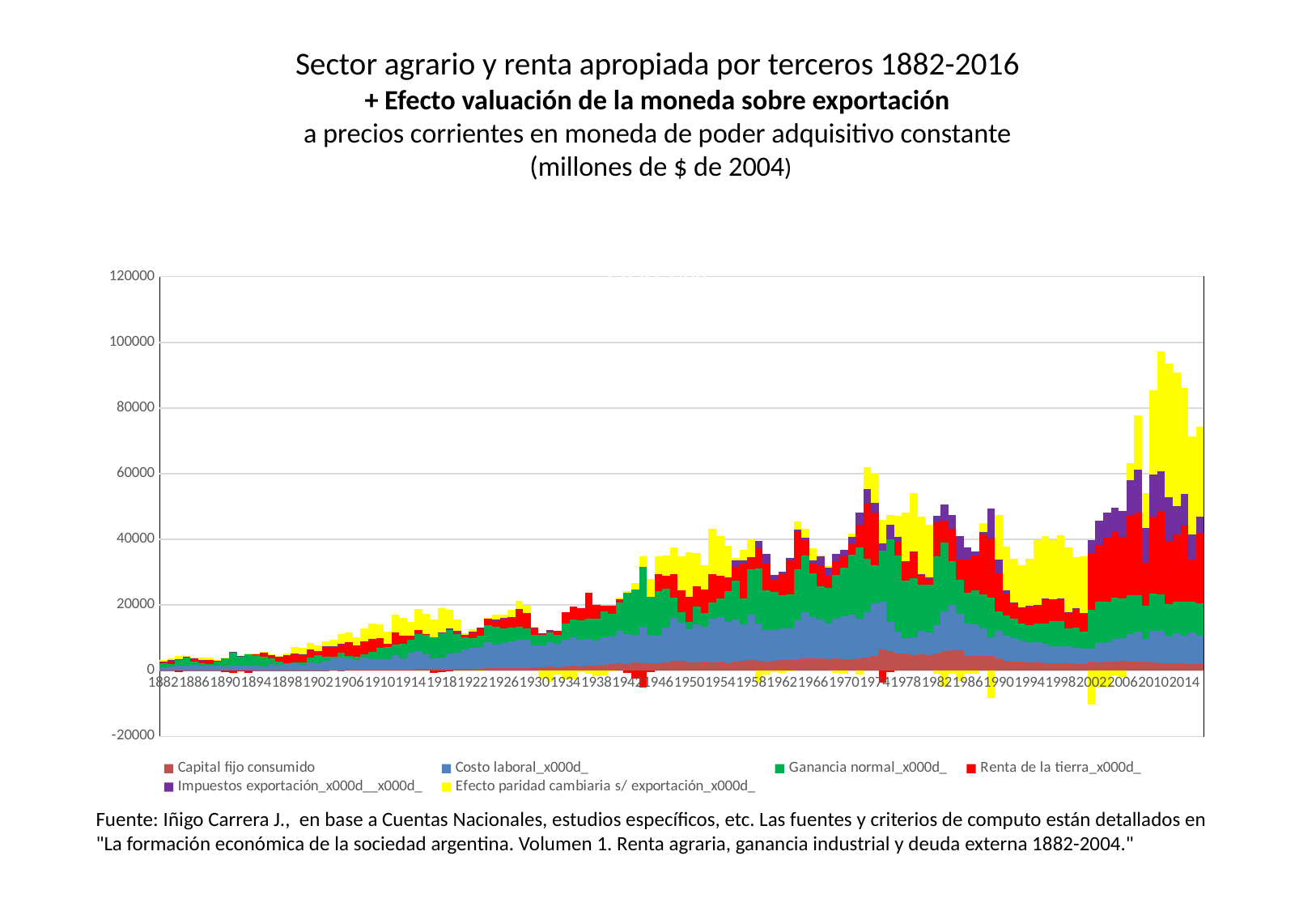
What kind of chart is shown on the slide? Stacked bar chart Which series is shown in yellow? Efecto paridad cambiaria s/ exportación_x000d_ Is the stacked total for 1930 greater or less than 40000? less Do the stacked totals generally rise or fall from 1882 to 2016? Rise Which series is shown in red? Renta de la tierra_x000d_ Is the stacked total for 1882 greater or less than 20000? less How many series does the legend list? 6 Is the stacked total for 1950 greater or less than 60000? less